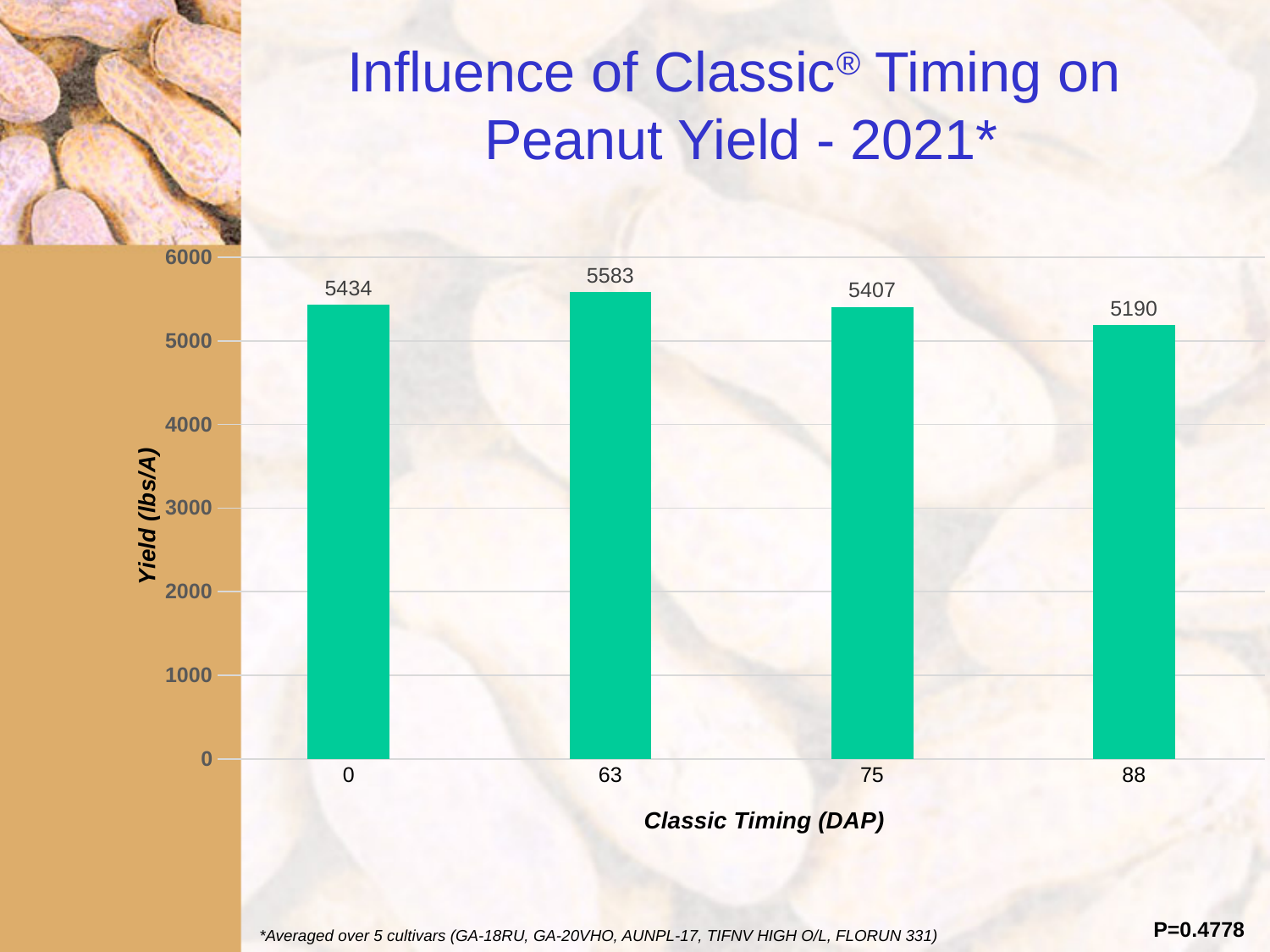
What is the yield for Classic timing of 0 DAP? 5434 Which Classic timing has the highest yield? 63 Is the yield for 88 DAP greater or less than 5000? greater Which Classic timing has the lowest yield? 88 What is the difference in yield between 63 DAP and 88 DAP? 393 What is the yield for Classic timing of 88 DAP? 5190 What is the yield for Classic timing of 63 DAP? 5583 How many Classic timing categories are shown on the chart? 4 What is the difference in yield between 0 DAP and 75 DAP? 27 What kind of chart is shown on the slide? bar chart Which has a higher yield, 63 DAP or 75 DAP? 63 DAP What is the label of the y axis? Yield (lbs/A)